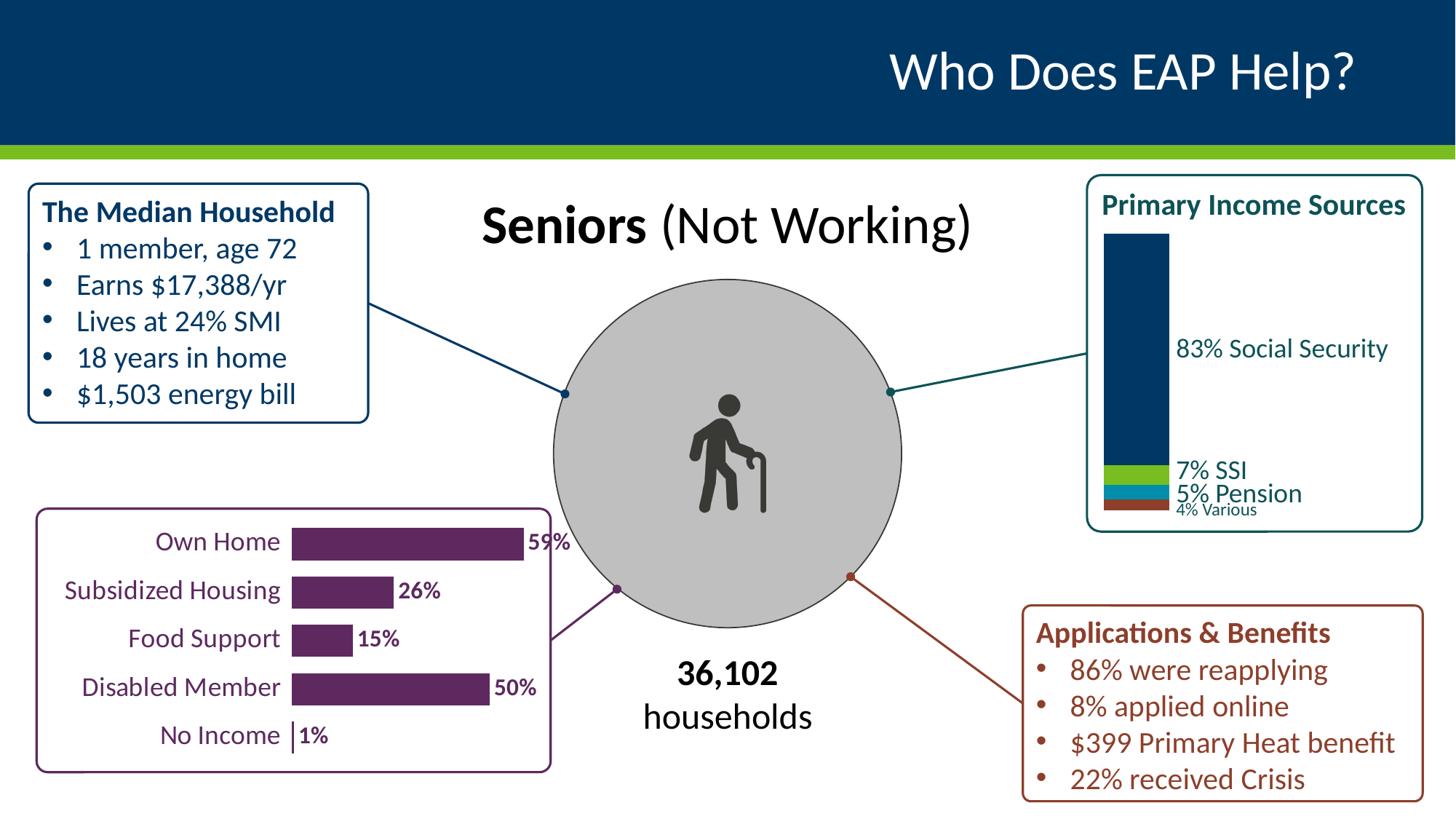
In the Primary Income Sources chart, what is the difference between SSI and Pension? 2% What kind of chart is the bottom-left chart? Bar chart In the Primary Income Sources chart, which segment is the smallest? Various In the bottom-left bar chart, which category has the highest value? Own Home In the bottom-left bar chart, what is the value for Subsidized Housing? 26% In the Primary Income Sources chart, what share is Social Security? 83% In the bottom-left bar chart, what is the difference between Own Home and Disabled Member? 9% In the bottom-left bar chart, which category has the lowest value? No Income In the bottom-left bar chart, what is the value for Own Home? 59% In the bottom-left bar chart, which is larger, Subsidized Housing or Food Support? Subsidized Housing In the bottom-left bar chart, what is the value for Food Support? 15% How many categories does the bottom-left bar chart show? 5